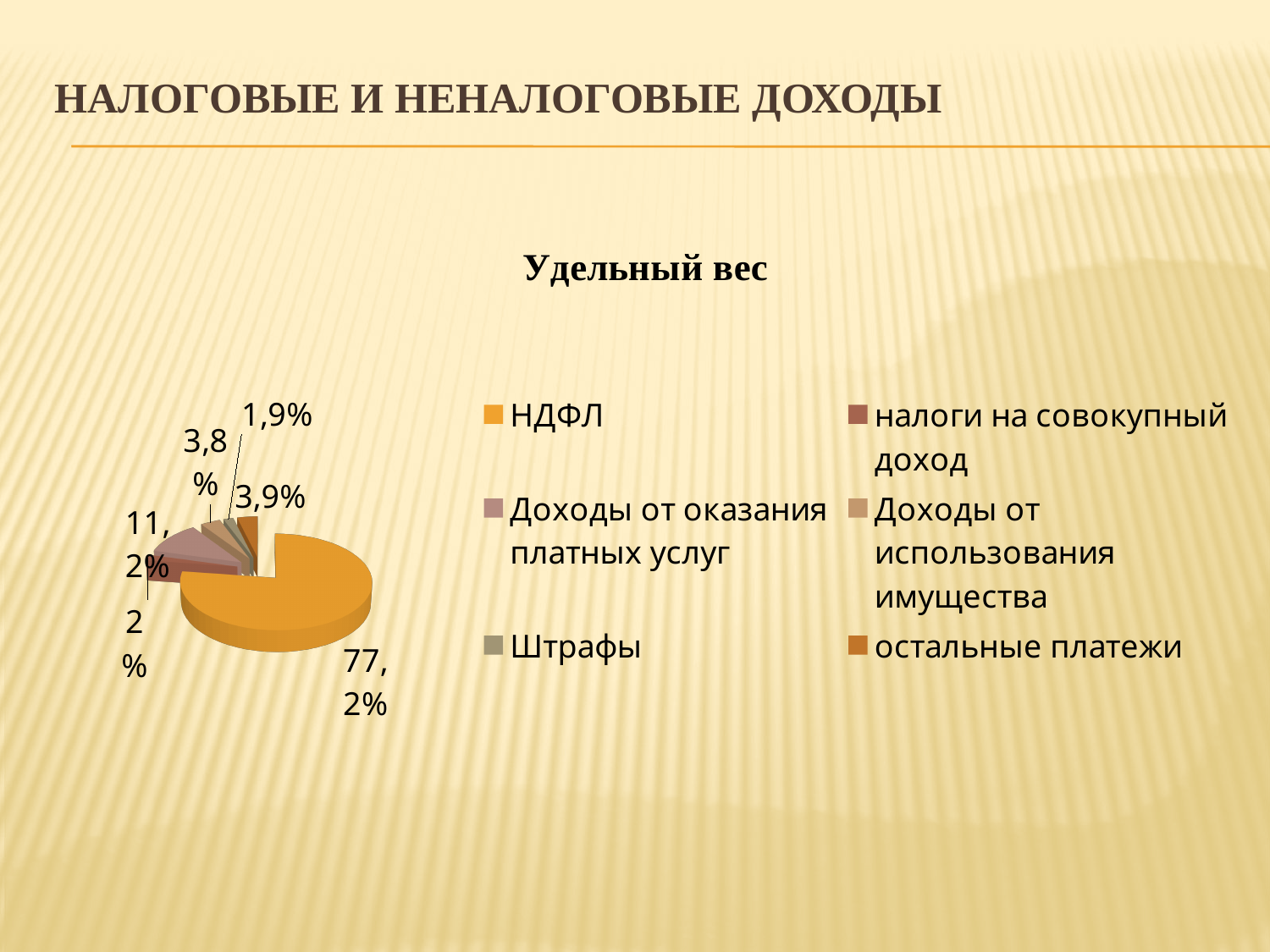
Which category has the largest share of the pie? НДФЛ Which is larger, the share of остальные платежи or the share of Доходы от оказания платных услуг? Доходы от оказания платных услуг What share of the pie does НДФЛ have? 77,2% What is the title of the chart? Удельный вес What is the difference in percentage points between the shares of НДФЛ and налоги на совокупный доход? 75,2 percentage points What share of the pie does остальные платежи have? 3,9% What share of the pie does Доходы от использования имущества have? 3,8% Which category has the smallest share of the pie? Штрафы How many categories does the legend of the pie chart list? 6 What kind of chart is shown on the slide? pie chart